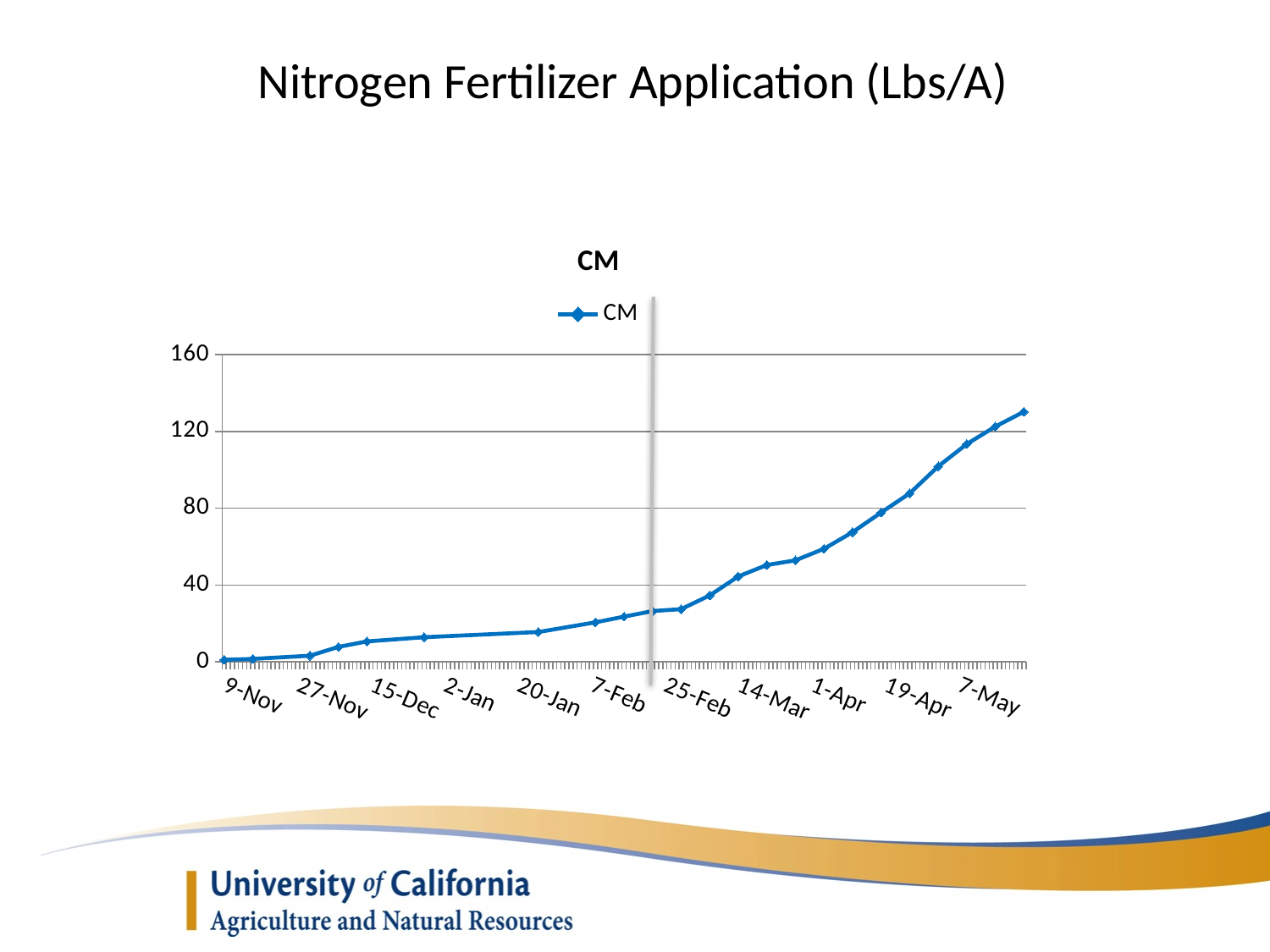
Is the value for 1-Apr greater or less than 80? less Is the value for 7-Feb greater or less than 40? less How many series does the legend list? 1 What kind of chart is shown on the slide? line chart What is the name of the series shown in the legend? CM What is the title of the chart? CM Is the value for 9-Nov greater or less than 40? less How many date labels are shown on the x axis? 11 Do the values rise or fall along the x axis from 9-Nov to 7-May? rise Which date has a larger value, 15-Dec or 14-Mar? 14-Mar